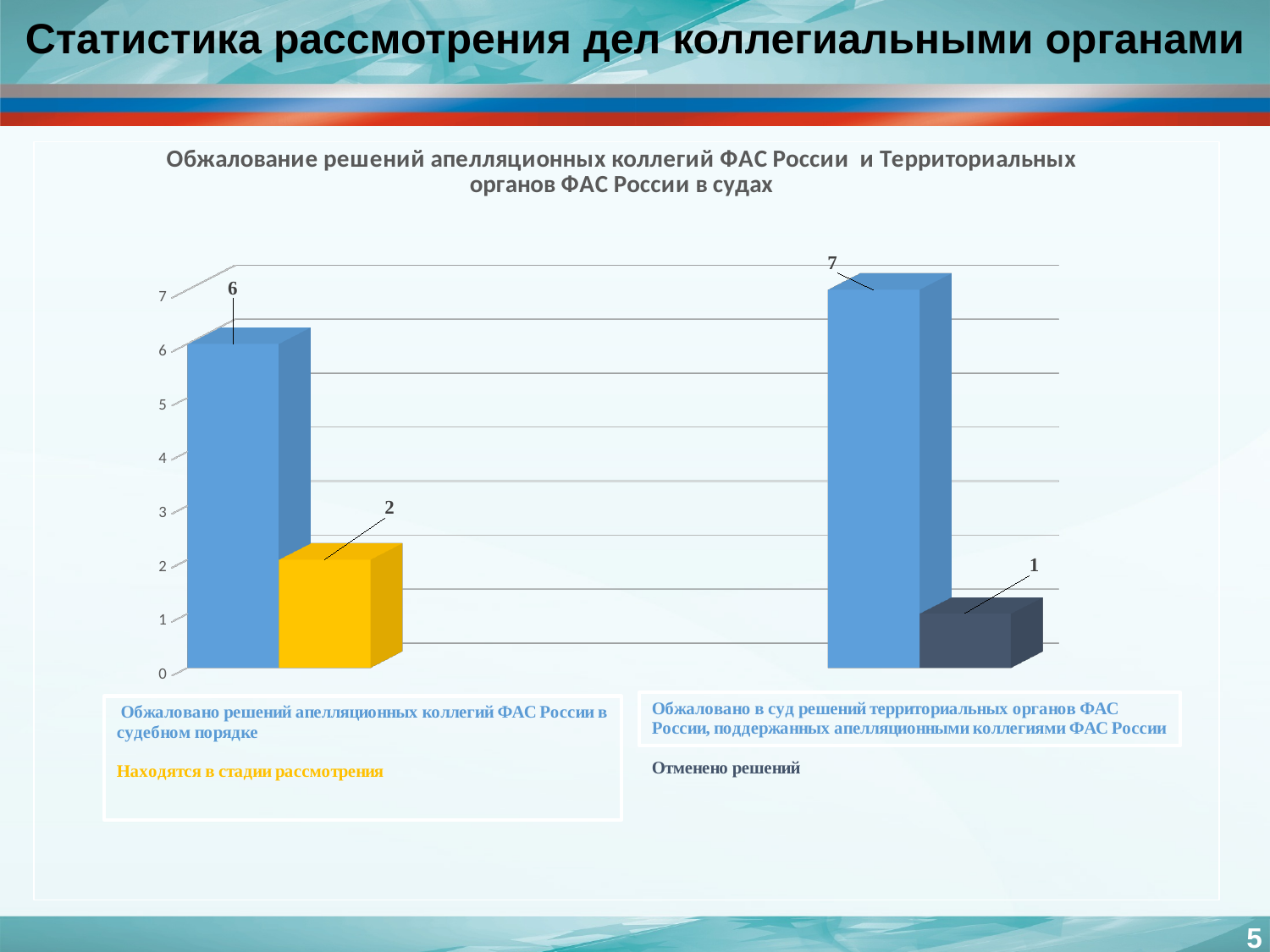
What is the difference between the bar for "Обжаловано в суд решений территориальных органов ФАС России" and the bar for "Отменено решений"? 6 What is the value of the bar labelled "Отменено решений"? 1 Which bar has the lowest value on the chart? Отменено решений What is the title of the chart? Обжалование решений апелляционных коллегий ФАС России и Территориальных органов ФАС России в судах How many bars are plotted on the chart? 4 What is the value of the bar for "Обжаловано решений апелляционных коллегий ФАС России в судебном порядке"? 6 What is the difference between the bar for "Обжаловано решений апелляционных коллегий ФАС России в судебном порядке" and the bar for "Находятся в стадии рассмотрения"? 4 Which bar has the highest value on the chart? Обжаловано в суд решений территориальных органов ФАС России, поддержанных апелляционными коллегиями ФАС России What is the value of the bar for "Обжаловано в суд решений территориальных органов ФАС России, поддержанных апелляционными коллегиями ФАС России"? 7 What type of chart is shown on the slide? Bar chart Which is larger: the bar for "Находятся в стадии рассмотрения" or the bar for "Отменено решений"? Находятся в стадии рассмотрения What is the value of the bar labelled "Находятся в стадии рассмотрения"? 2